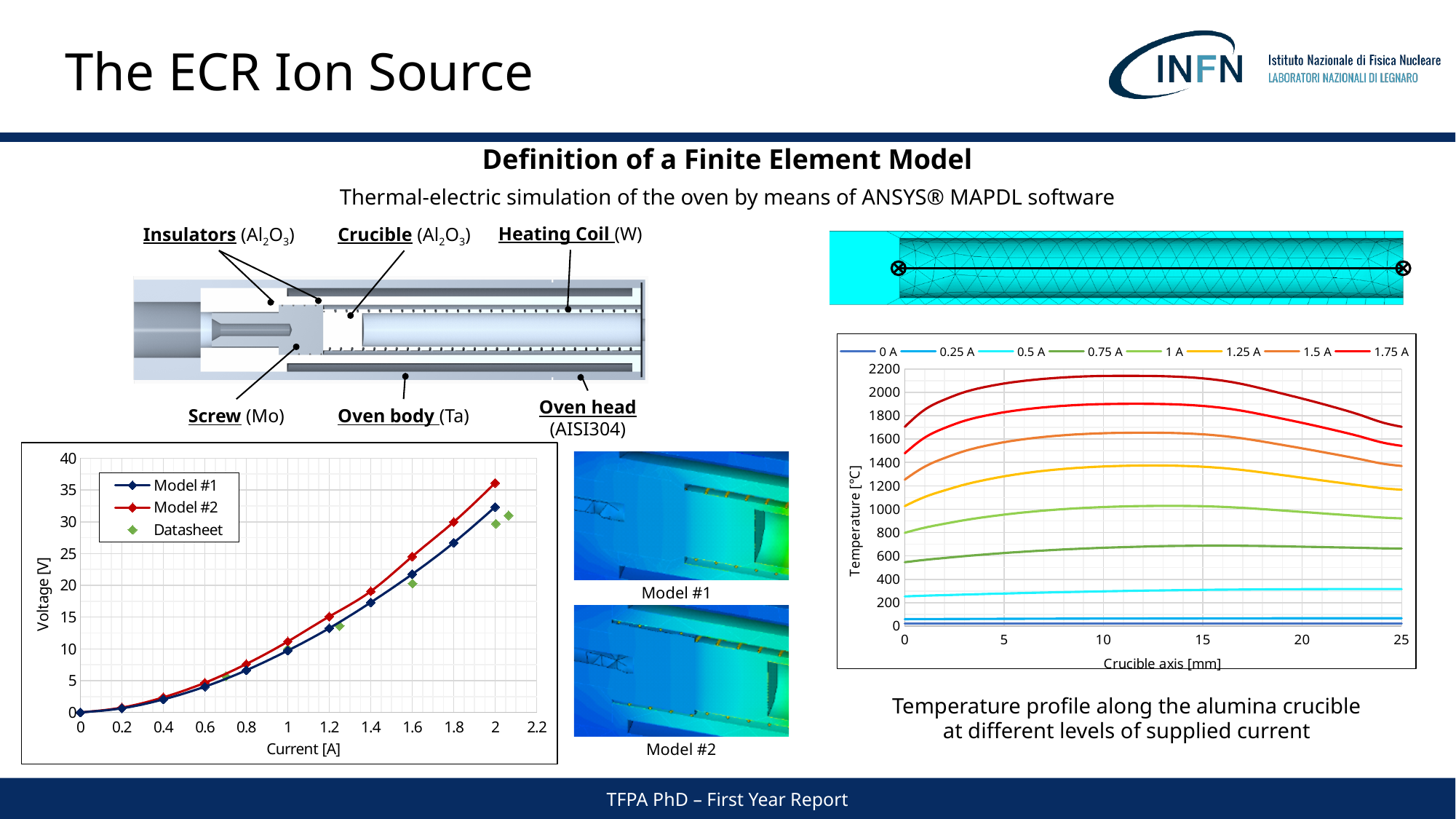
In the temperature profile chart on the right, which current level gives the lowest temperature along the crucible axis? 0 A What kind of chart is the temperature profile chart on the right? line chart In the temperature profile chart on the right, how many series does the legend list? 8 In the temperature profile chart on the right, is the temperature for 1.75 A at 0 mm greater or less than 1600? less In the voltage-versus-current chart on the left, at a current of 2 A, which is larger: the voltage for Model #1 or for Model #2? Model #2 In the temperature profile chart on the right, is the temperature for 0.75 A at 25 mm greater or less than 800? less In the voltage-versus-current chart on the left, how many series does the legend list? 3 In the voltage-versus-current chart on the left, is the voltage for Model #1 at 2 A greater or less than 30? greater In the voltage-versus-current chart on the left, does the voltage for Model #1 rise or fall as the current increases? rise What is the x-axis label of the temperature profile chart on the right? Crucible axis [mm]